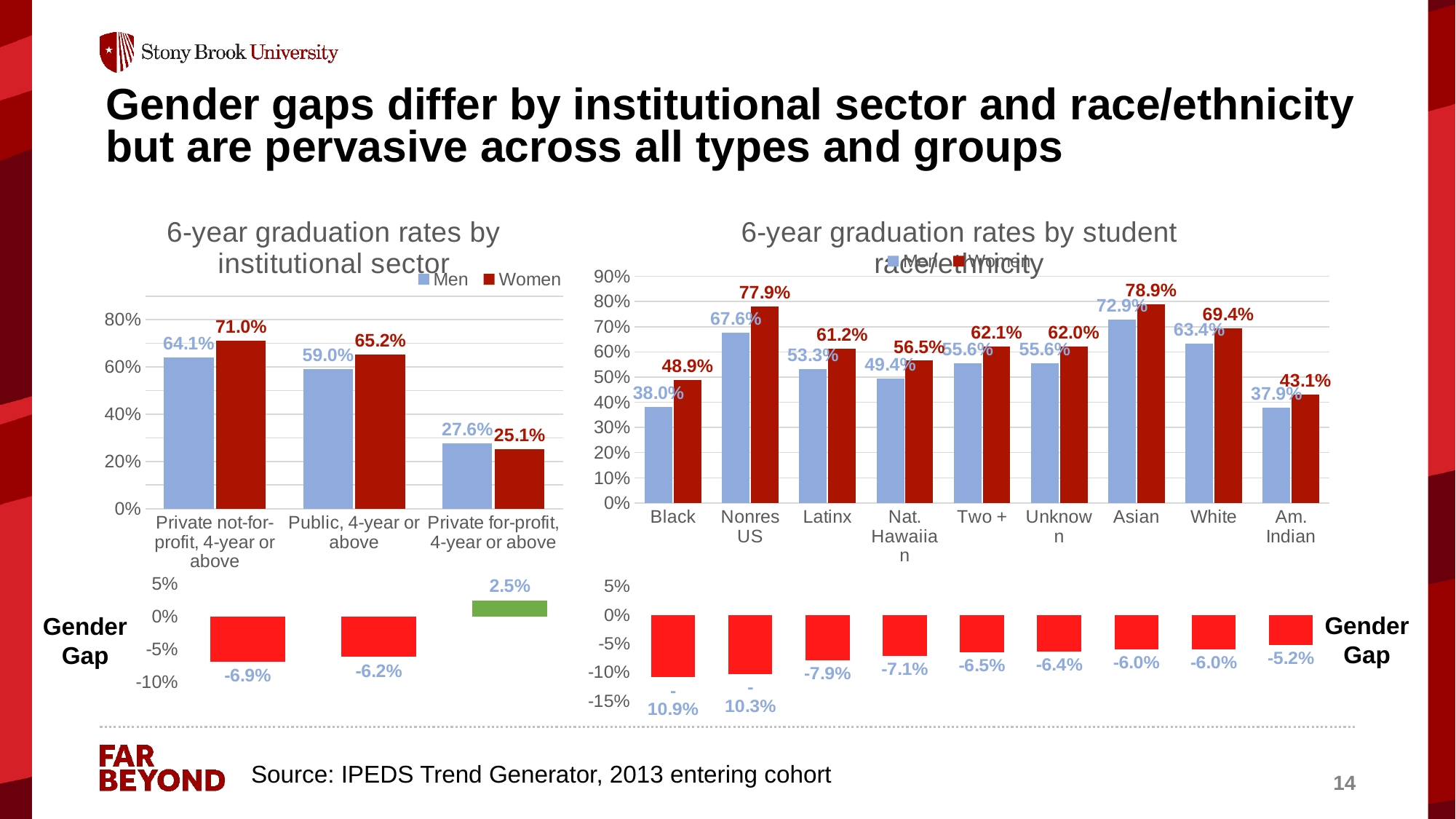
In the chart '6-year graduation rates by institutional sector', what is the value for Men at Private for-profit, 4-year or above institutions? 27.6% In the chart '6-year graduation rates by institutional sector', what is the value for Women at Public, 4-year or above institutions? 65.2% In the Gender Gap chart below the race/ethnicity chart, what is the gender gap value for Latinx? -7.9% How many categories are shown on the x axis of the chart '6-year graduation rates by student race/ethnicity'? 9 In the chart '6-year graduation rates by student race/ethnicity', which is larger: the Women value for White or the Women value for Nonres US? Nonres US In the chart '6-year graduation rates by student race/ethnicity', what is the value for Women in the Asian category? 78.9% In the chart '6-year graduation rates by student race/ethnicity', which category has the lowest value for Men? Am. Indian In the chart '6-year graduation rates by student race/ethnicity', which category has the highest value for Men? Asian How many series does the legend of the chart '6-year graduation rates by institutional sector' list? 2 In the chart '6-year graduation rates by student race/ethnicity', what is the value for Men in the Black category? 38.0% What kind of chart is '6-year graduation rates by student race/ethnicity'? Bar chart In the chart '6-year graduation rates by institutional sector', what is the difference between the Women and Men values at Private not-for-profit, 4-year or above institutions? 6.9%